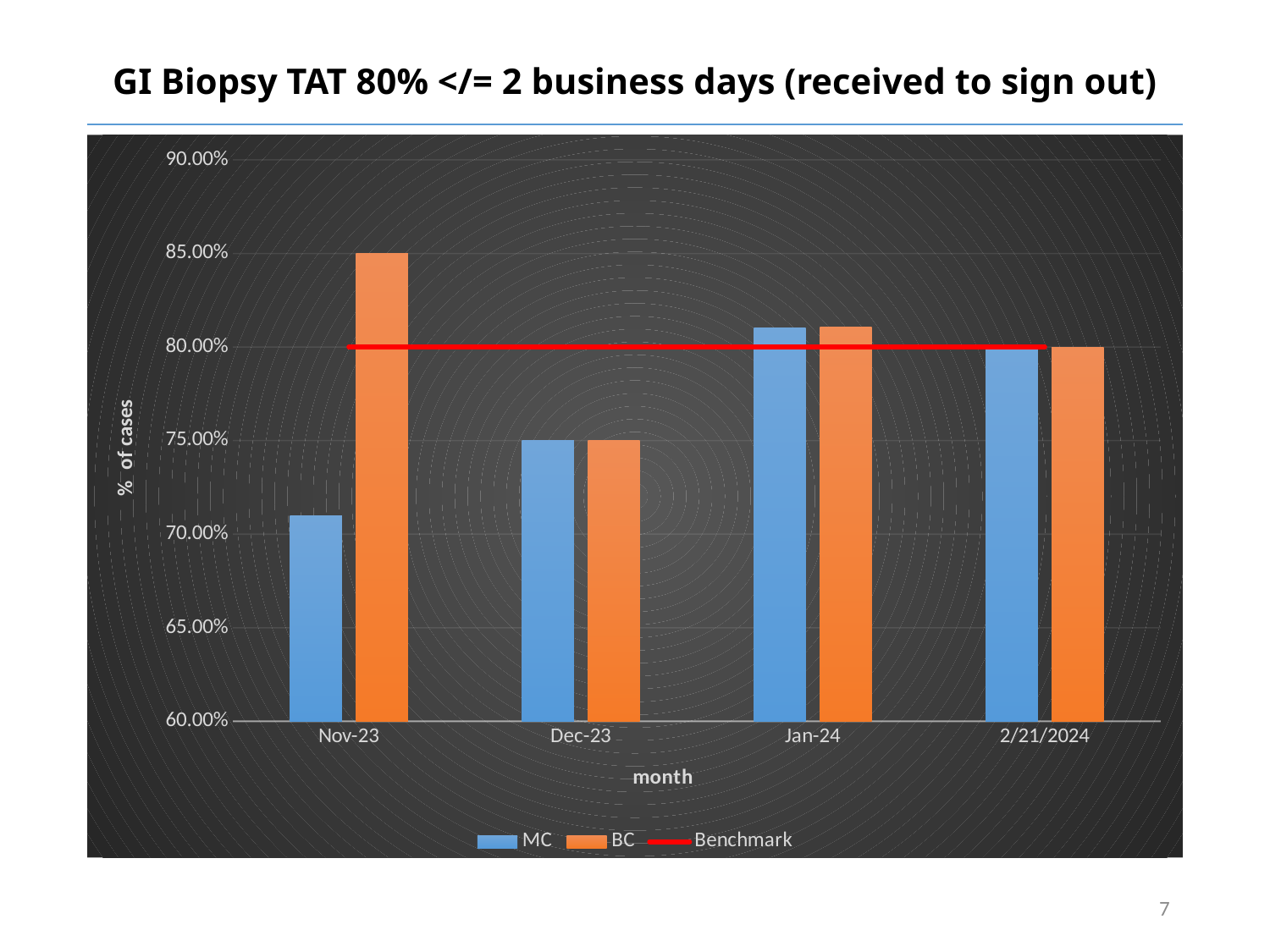
Is the BC value for Nov-23 greater or less than 80.00%? greater How many series does the legend list? 3 Which month and series has the lowest bar? MC in Nov-23 What kind of chart is shown on the slide? combination bar and line chart What is the label of the y axis? % of cases In Nov-23, which series has the larger value, MC or BC? BC Is the MC value for Nov-23 greater or less than 75.00%? less Is the MC value for Jan-24 greater or less than 80.00%? greater What does the red horizontal line represent according to the legend? Benchmark Which month and series has the highest bar? BC in Nov-23 Does the MC value rise or fall from Nov-23 to Dec-23? rise How many months (categories) are shown on the x axis? 4